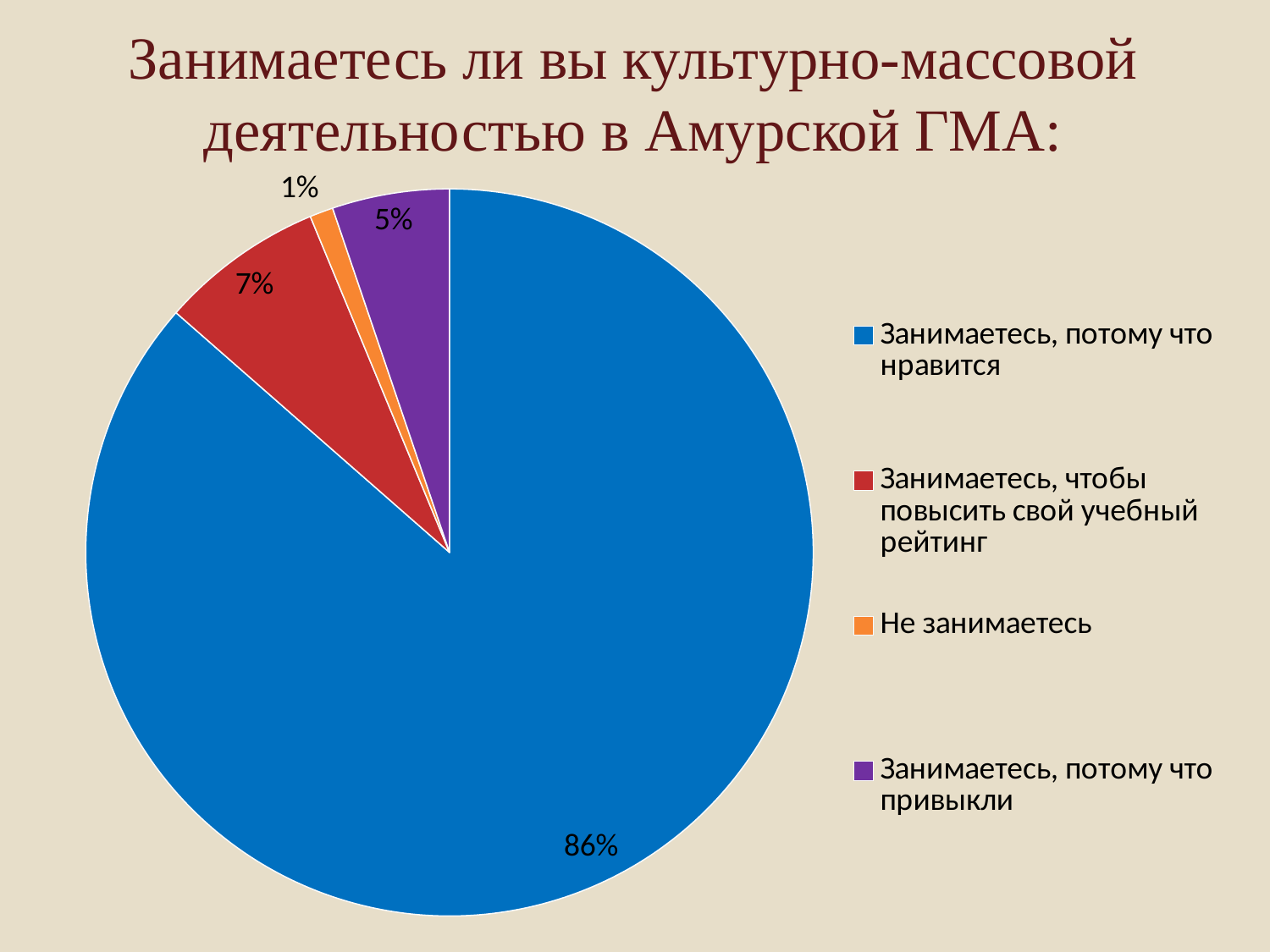
What is the title of the chart? Занимаетесь ли вы культурно-массовой деятельностью в Амурской ГМА: What is the difference between the shares for "Занимаетесь, чтобы повысить свой учебный рейтинг" and "Занимаетесь, потому что привыкли"? 2% Which category has the smallest slice of the pie? Не занимаетесь Which category has the largest slice of the pie? Занимаетесь, потому что нравится Which is larger: the share for "Занимаетесь, потому что привыкли" or the share for "Не занимаетесь"? Занимаетесь, потому что привыкли What share of the pie is labelled "Занимаетесь, чтобы повысить свой учебный рейтинг"? 7% What share of the pie is labelled "Не занимаетесь"? 1% What colour is the slice for "Не занимаетесь"? orange What kind of chart is shown on the slide? pie chart What share of the pie is labelled "Занимаетесь, потому что привыкли"? 5% How many categories does the pie chart have? 4 What share of the pie is labelled "Занимаетесь, потому что нравится"? 86%